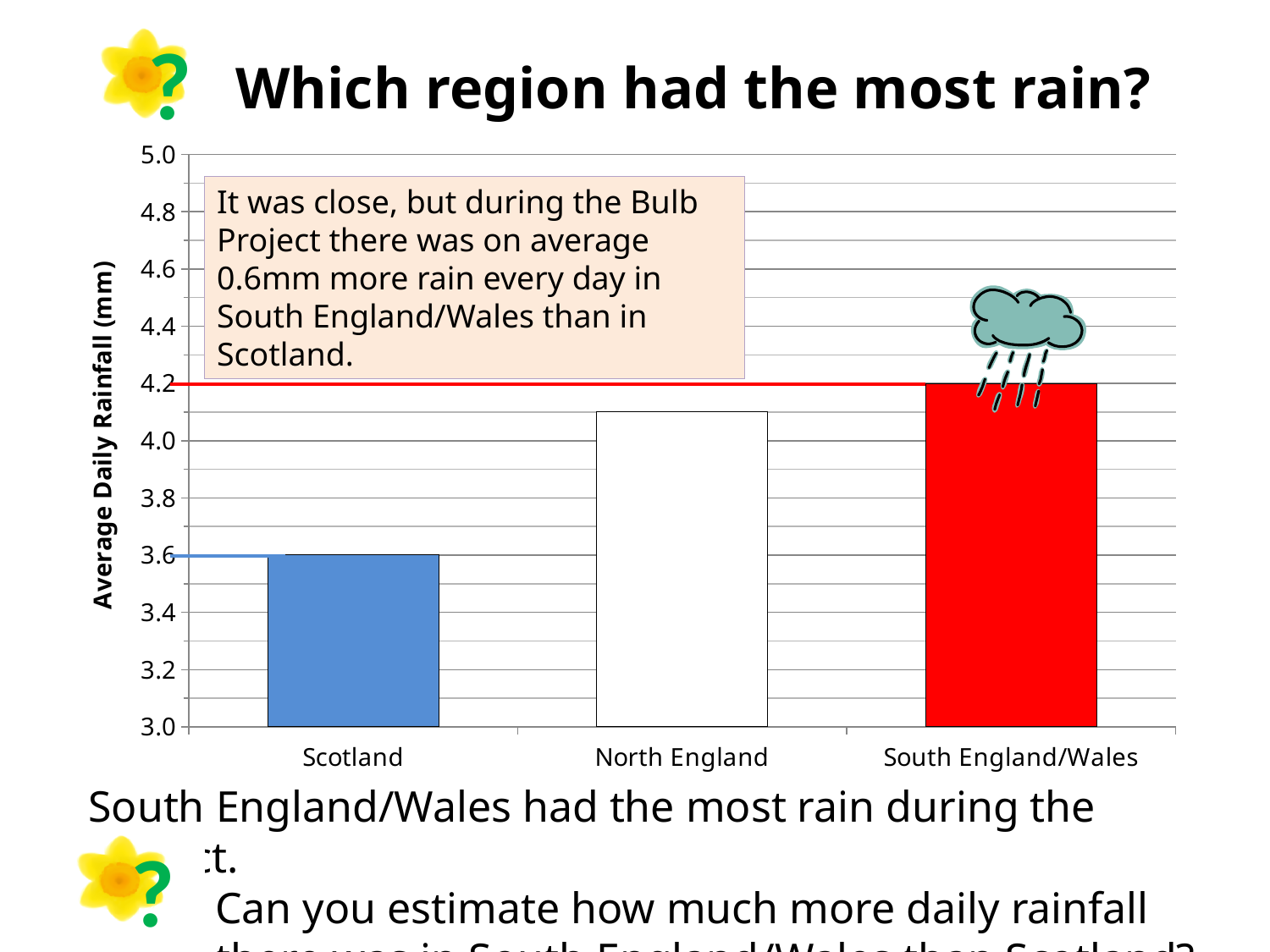
What is the average daily rainfall for South England/Wales? 4.2 Is the value for North England greater or less than 4.0? greater What is the average daily rainfall for Scotland? 3.6 How much more daily rainfall was there in South England/Wales than in Scotland? 0.6mm Which region has the highest average daily rainfall in the chart? South England/Wales What is the label on the vertical axis of the chart? Average Daily Rainfall (mm) Which region has the lowest average daily rainfall in the chart? Scotland Which has a larger average daily rainfall, North England or Scotland? North England Is the value for North England greater or less than 4.2? less Do the bar values rise or fall from left to right across the chart? rise What type of chart is shown on the slide? bar chart How many regions are shown on the x axis of the chart? 3